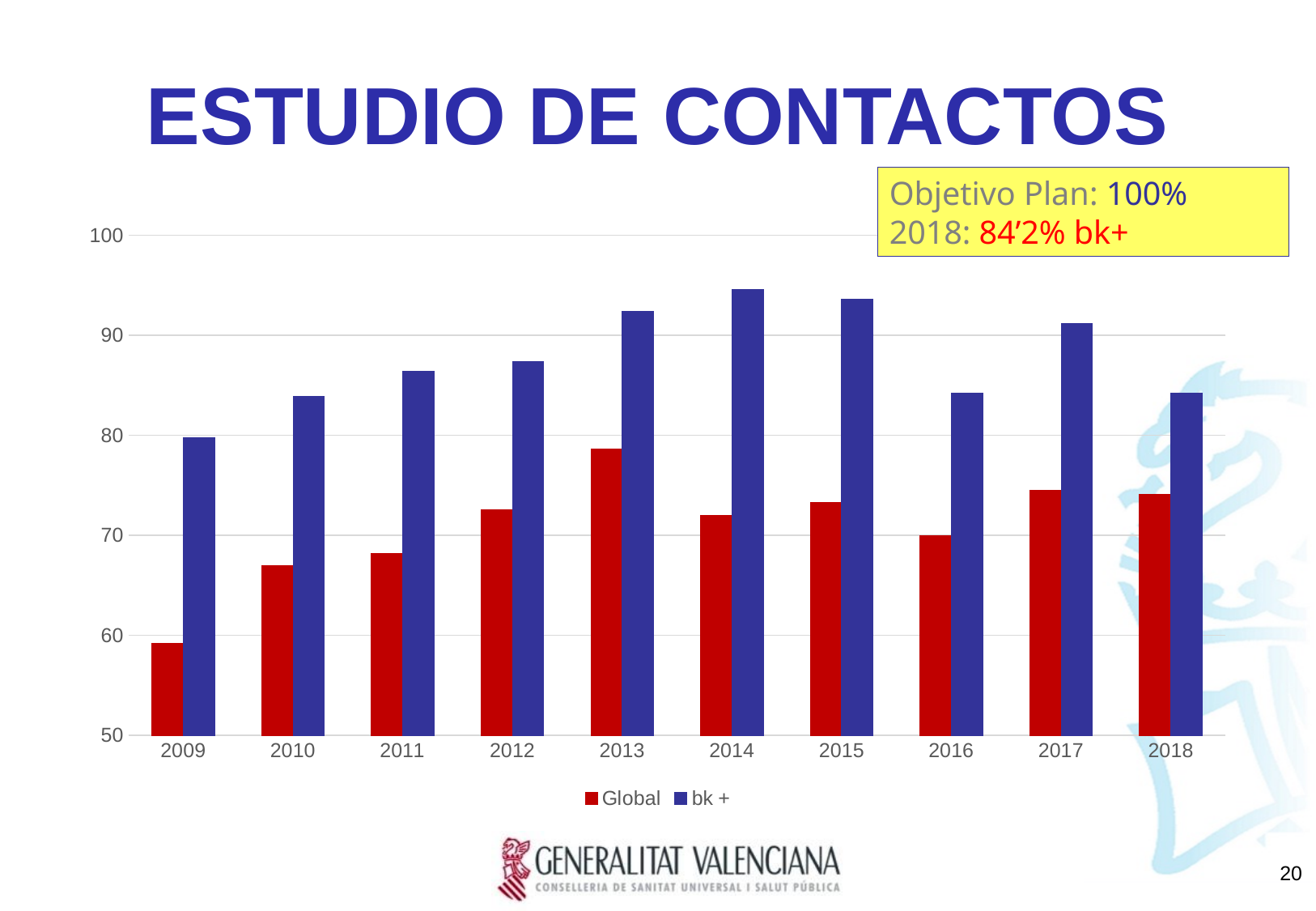
In which year is the Global value lowest? 2009 Is the bk + value for 2010 greater or less than 90? less Which is larger, the bk + value for 2013 or the bk + value for 2016? 2013 In which year is the bk + value highest? 2014 How many years are shown on the x axis of the chart? 10 Is the Global value for 2009 greater or less than 60? less Which colour represents the Global series in the chart? red Is the bk + value for 2014 greater or less than 90? greater How many series does the chart's legend list? 2 In which year is the bk + value lowest? 2009 What kind of chart is shown on the slide? bar chart In which year is the Global value highest? 2013